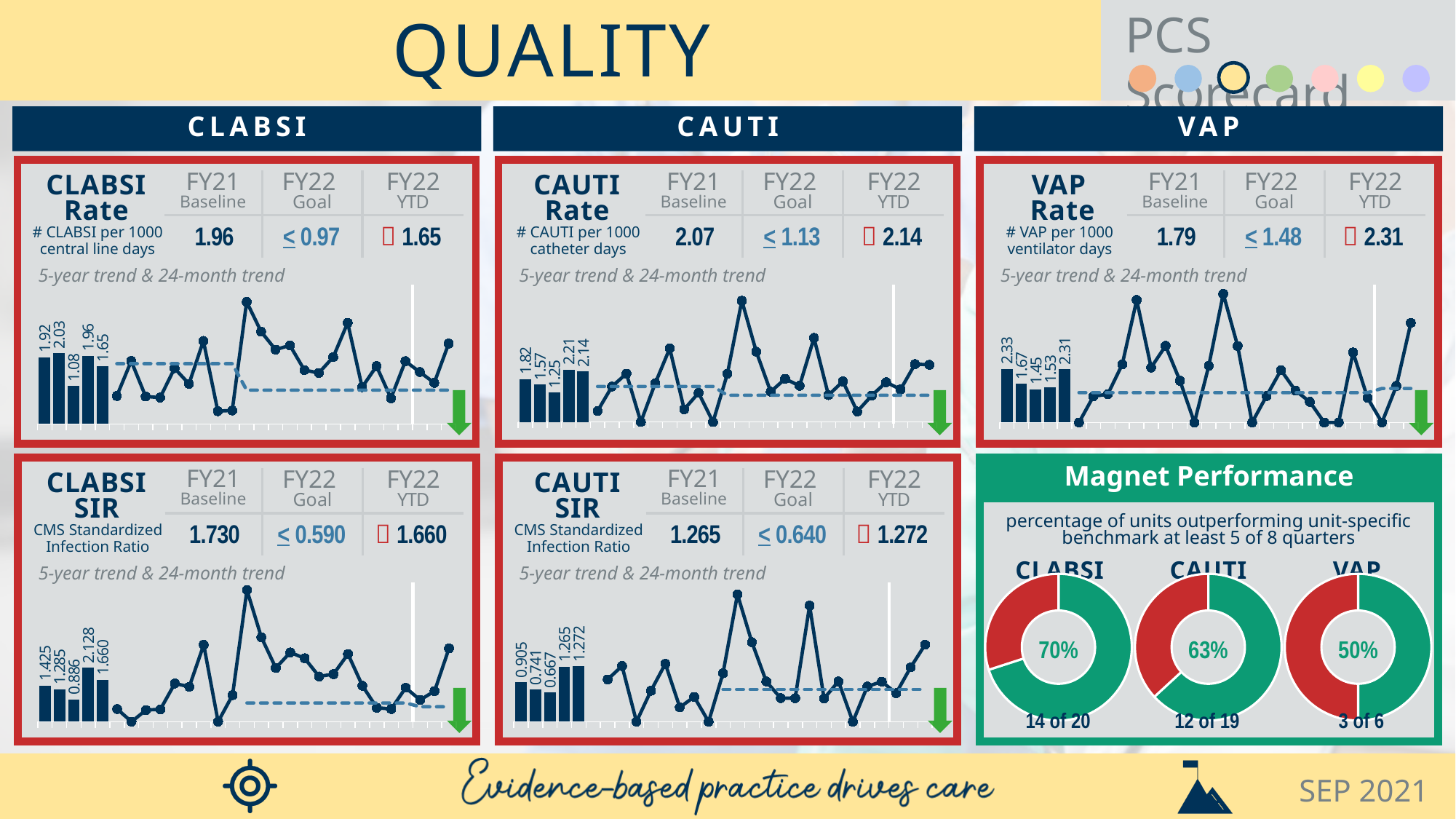
How many bars are in the CLABSI Rate 5-year trend bar chart? 5 In the CAUTI SIR 5-year trend bar chart, what is the value of the lowest bar? 0.667 In the Magnet Performance section, how many units are reported for CAUTI (the 'x of y' label under the donut)? 12 of 19 In the CAUTI Rate 5-year trend bar chart, what is the value of the highest bar? 2.21 In the VAP Rate 5-year trend bar chart, what is the value of the lowest bar? 1.45 In the CLABSI Rate 5-year trend bar chart, what is the value of the lowest bar? 1.08 In the Magnet Performance section, which donut chart shows the larger percentage, CAUTI or VAP? CAUTI In the CLABSI Rate 5-year trend bar chart, what is the value of the highest bar? 2.03 In the Magnet Performance section, what percentage is shown in the CLABSI donut chart? 70% In the Magnet Performance section, what percentage is shown in the VAP donut chart? 50% In the VAP Rate 5-year trend bar chart, what is the difference between the highest bar (2.33) and the lowest bar (1.45)? 0.88 In the CLABSI SIR 5-year trend bar chart, what is the value of the highest bar? 2.128